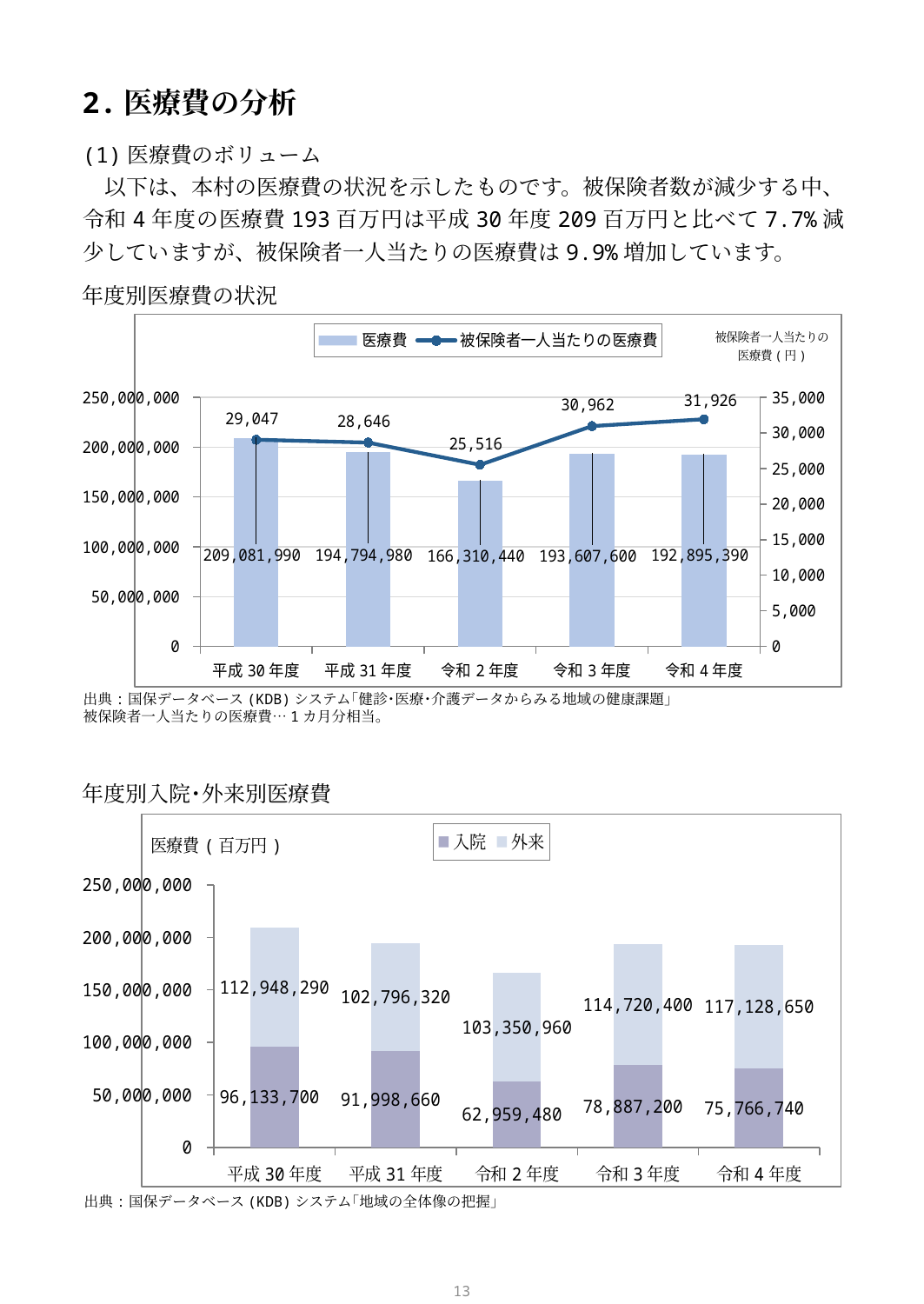
In the 年度別医療費の状況 chart, what is the difference in 被保険者一人当たりの医療費 between 平成30年度 and 令和2年度? 3,531 In the 年度別入院・外来別医療費 chart, how many years are shown on the x axis? 5 In the 年度別医療費の状況 chart, which year has the lowest 被保険者一人当たりの医療費? 令和2年度 In the 年度別医療費の状況 chart, what is the 医療費 value for 令和2年度? 166,310,440 In the 年度別入院・外来別医療費 chart, what is the 入院 value for 令和3年度? 78,887,200 In the 年度別入院・外来別医療費 chart, which year has the lowest 入院 value? 令和2年度 In the 年度別入院・外来別医療費 chart, what is the 外来 value for 平成31年度? 102,796,320 In the 年度別医療費の状況 chart, which year has the highest 医療費? 平成30年度 In the 年度別医療費の状況 chart, what is the 被保険者一人当たりの医療費 value for 令和4年度? 31,926 In the 年度別医療費の状況 chart, how many series does the legend list? 2 In the 年度別入院・外来別医療費 chart, what is the total of the stacked bar for 令和2年度? 166,310,440 In the 年度別入院・外来別医療費 chart, is the 外来 value for 令和4年度 larger than the 入院 value for 令和4年度? Yes